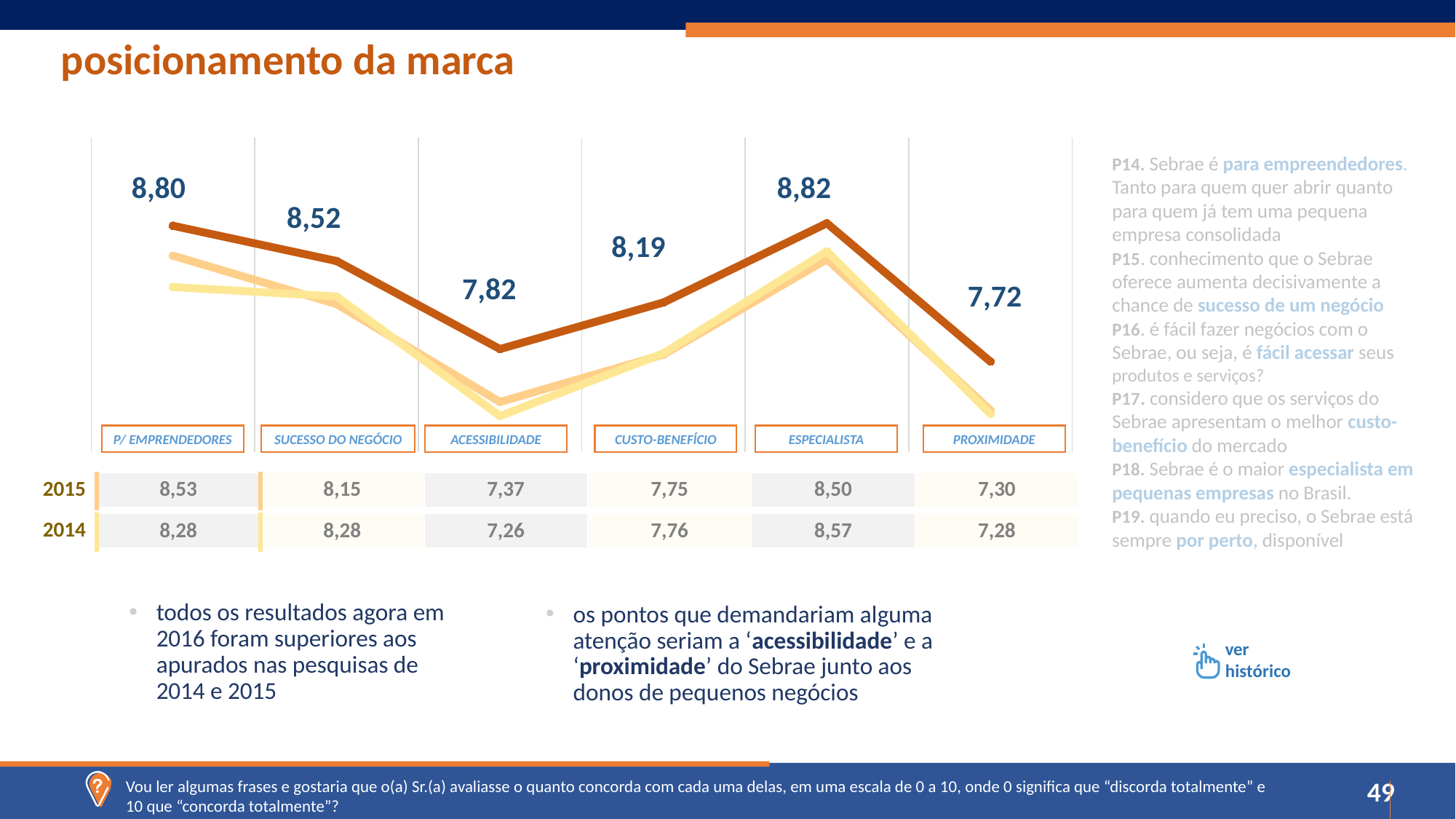
Which is larger: the 2015 value for ACESSIBILIDADE or the 2014 value for ACESSIBILIDADE? 2015 (7,37) Which category has the highest 2016 value on the chart? ESPECIALISTA What is the 2016 value labelled on the chart for ESPECIALISTA? 8,82 What is the title of the slide containing the chart? posicionamento da marca What is the 2014 value shown for PROXIMIDADE? 7,28 What is the 2016 value labelled on the chart for ACESSIBILIDADE? 7,82 How many categories are plotted along the x axis of the chart? 6 What is the 2015 value shown for CUSTO-BENEFÍCIO? 7,75 What is the difference between the 2016 value for P/ EMPRENDEDORES (8,80) and the 2016 value for SUCESSO DO NEGÓCIO (8,52)? 0,28 Which category has the lowest 2016 value on the chart? PROXIMIDADE What kind of chart is shown on the slide? line chart Does the 2016 line rise or fall from CUSTO-BENEFÍCIO to ESPECIALISTA? rise